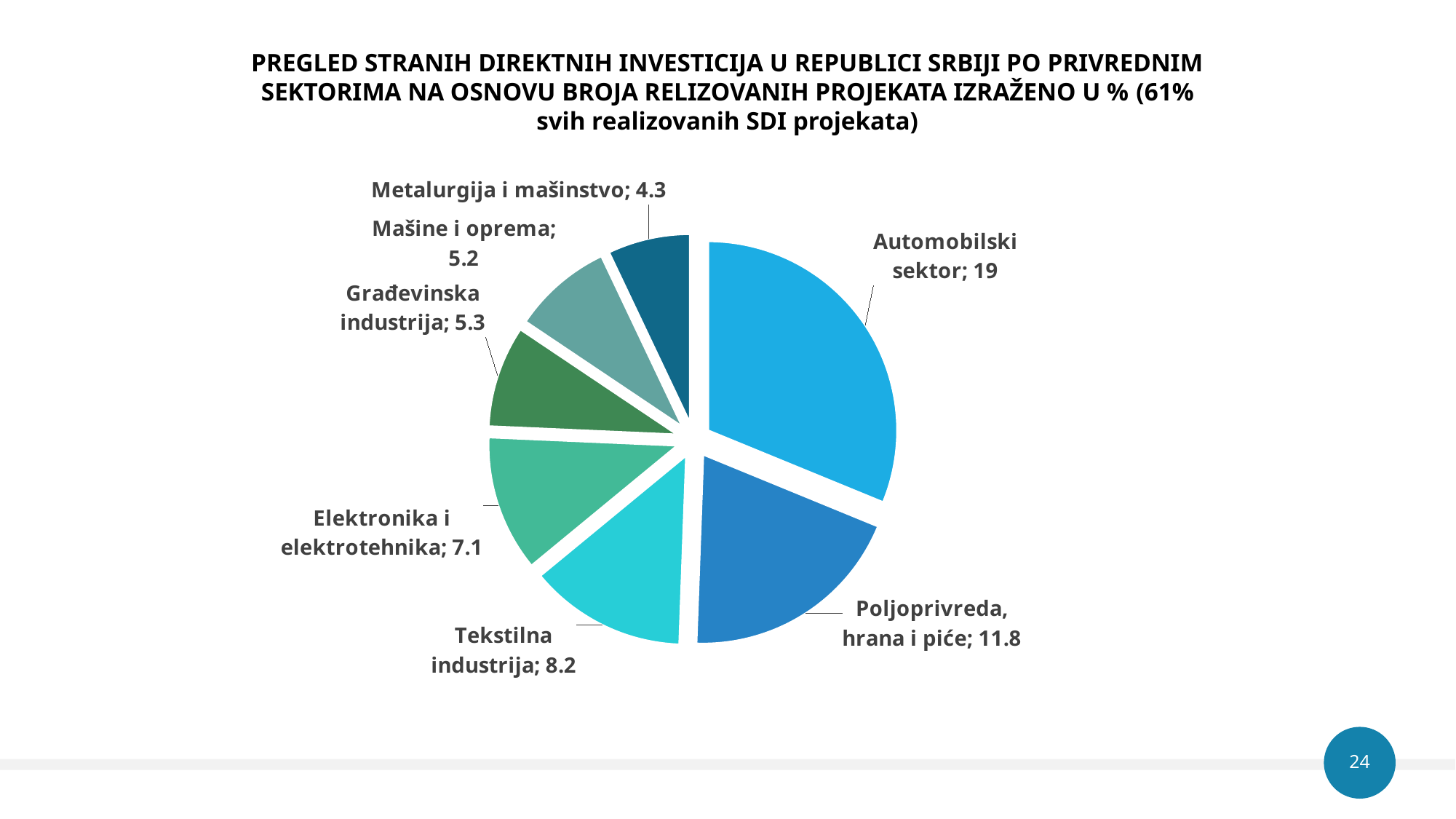
What kind of chart is shown on the slide? pie chart What is the value for Elektronika i elektrotehnika? 7.1 What is the value for Poljoprivreda, hrana i piće? 11.8 Which sector has the smallest slice of the pie? Metalurgija i mašinstvo What is the value for Automobilski sektor? 19 What is the difference between the values for Tekstilna industrija and Elektronika i elektrotehnika? 1.1 Which sector has the largest slice of the pie? Automobilski sektor Which is larger, the value for Tekstilna industrija or the value for Građevinska industrija? Tekstilna industrija How many sectors are shown in the pie chart? 7 What is the difference between the values for Automobilski sektor and Poljoprivreda, hrana i piće? 7.2 What is the value for Metalurgija i mašinstvo? 4.3 What is the value for Tekstilna industrija? 8.2